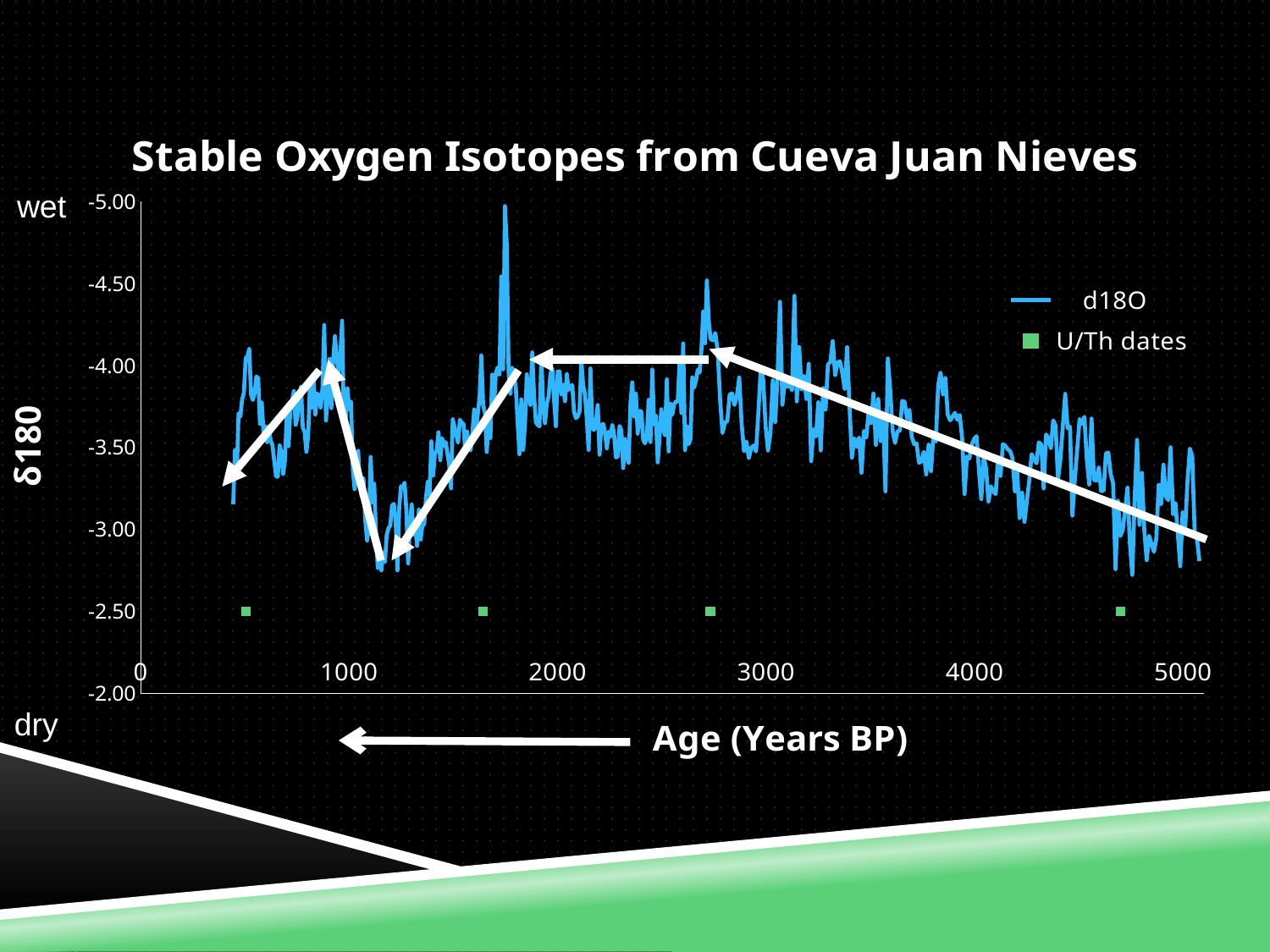
What value is shown at the top of the y axis, next to the label 'wet'? -5.00 Is the δ18O value at the dip just after 1000 years BP more negative or less negative than -3.00? less negative From 3000 to 5000 years BP, does the δ18O record trend toward wetter or drier conditions? drier Is the δ18O value at the highest peak (around 1700 years BP) more negative or less negative than -4.50? more negative What is the largest value shown on the x axis? 5000 What kind of chart is shown on the slide? line chart What is the label of the x axis? Age (Years BP) What is the title of the chart? Stable Oxygen Isotopes from Cueva Juan Nieves How many U/Th date markers are plotted on the chart? 4 What are the two entries in the chart legend? d18O and U/Th dates Between which two x-axis ticks does the most negative (wettest) δ18O peak occur? between 1000 and 2000 How many series does the chart legend list? 2